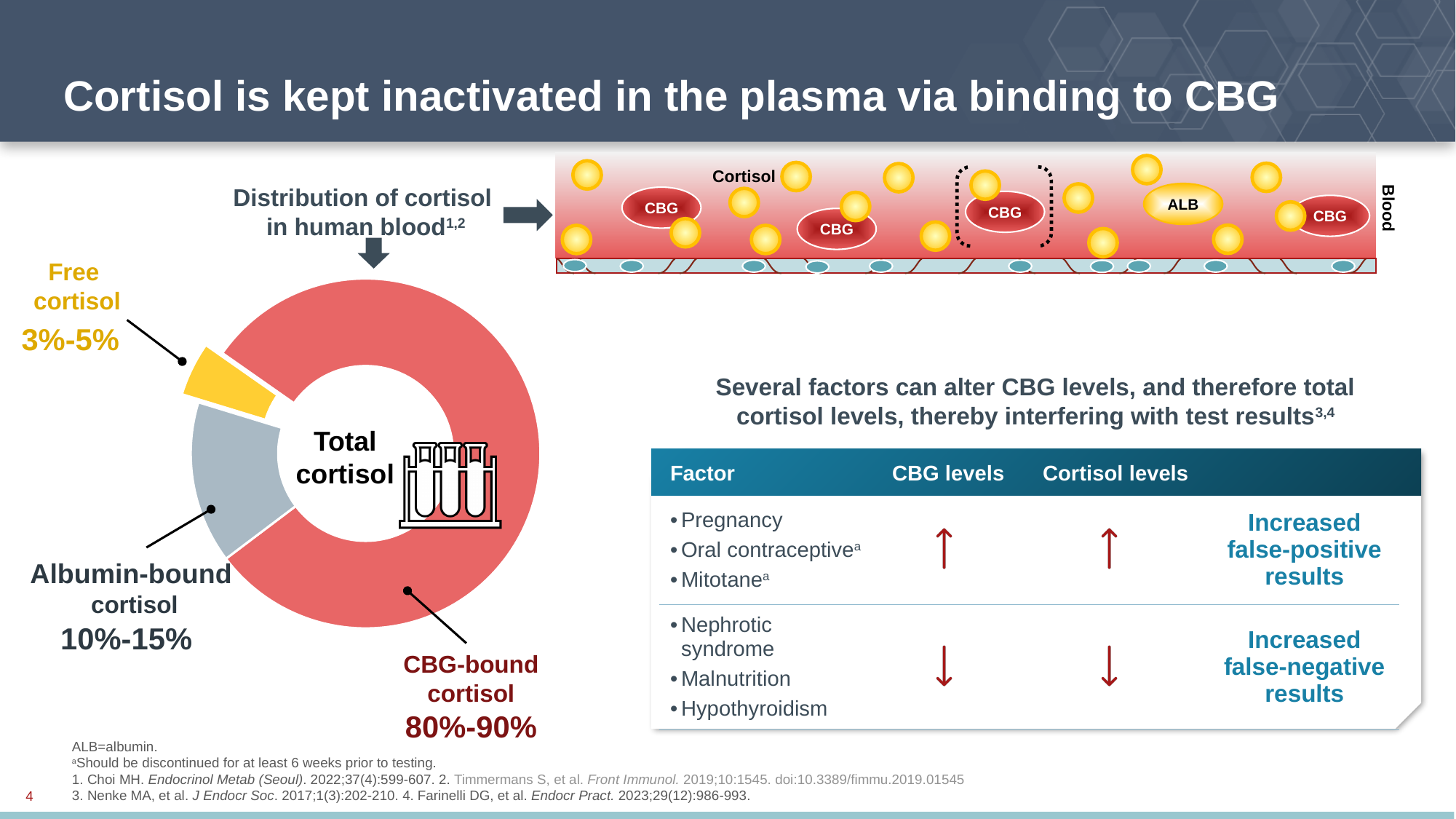
What share of total cortisol is albumin-bound cortisol according to the chart? 10%-15% Which is larger in the chart: the share of CBG-bound cortisol or the share of albumin-bound cortisol? CBG-bound cortisol What label appears in the centre of the donut chart? Total cortisol Which form of cortisol makes up the smallest share of total cortisol in the chart? Free cortisol What kind of chart is used to show the distribution of cortisol in human blood? Pie (donut) chart What share of total cortisol is free cortisol according to the chart? 3%-5% Which is larger in the chart: the share of albumin-bound cortisol or the share of free cortisol? Albumin-bound cortisol Which form of cortisol makes up the largest share of total cortisol in the chart? CBG-bound cortisol How many slices does the cortisol distribution chart have? 3 What colour is the free cortisol slice in the donut chart? Yellow What is the title of the donut chart on the slide? Distribution of cortisol in human blood What share of total cortisol is CBG-bound cortisol according to the chart? 80%-90%